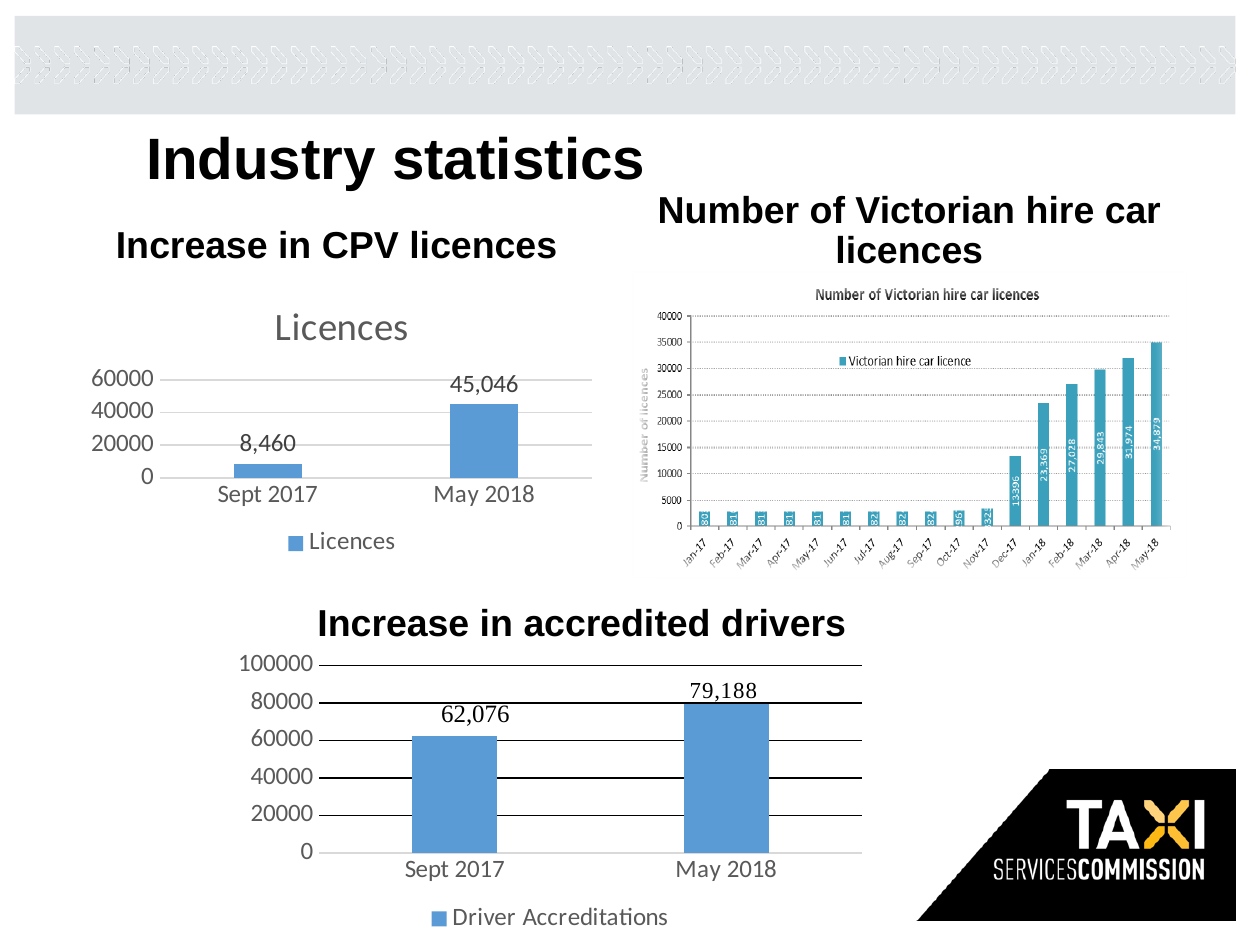
In the 'Licences' chart, what is the value for May 2018? 45,046 In the 'Licences' chart, how many categories are shown on the x axis? 2 In the 'Licences' chart, what is the difference between the May 2018 and Sept 2017 values? 36,586 In the 'Number of Victorian hire car licences' chart, what is the value for May-18? 34,879 In the 'Number of Victorian hire car licences' chart, which month has the highest value? May-18 In the 'Licences' chart, what is the value for Sept 2017? 8,460 What type of chart is the 'Number of Victorian hire car licences' chart? Bar chart In the 'Increase in accredited drivers' chart, which category has the higher value? May 2018 In the 'Increase in accredited drivers' chart, what series name does the legend show? Driver Accreditations In the 'Increase in accredited drivers' chart, what is the value for May 2018? 79,188 In the 'Increase in accredited drivers' chart, what is the difference between the May 2018 and Sept 2017 values? 17,112 In the 'Increase in accredited drivers' chart, what is the value for Sept 2017? 62,076